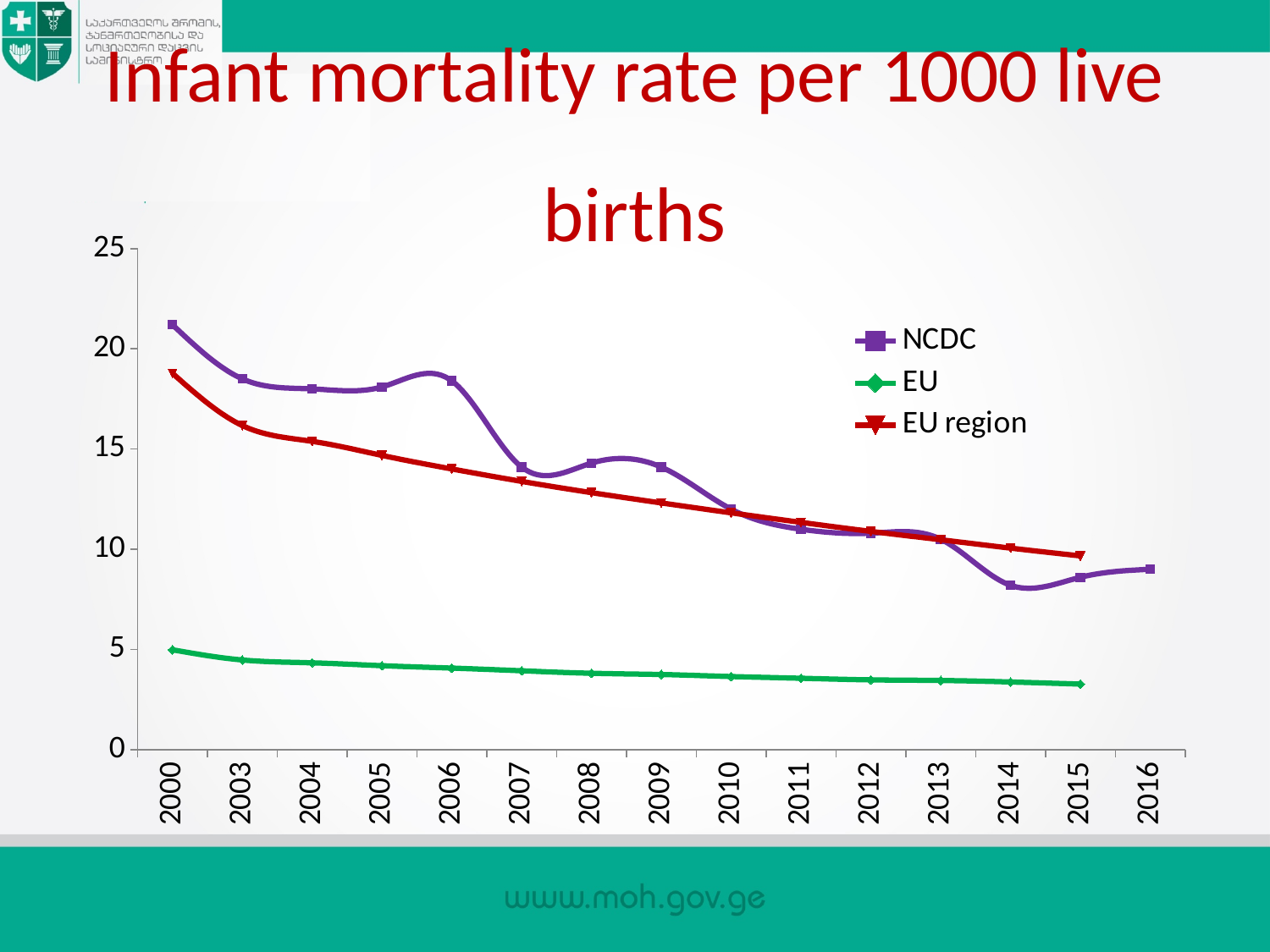
Does the EU region series rise or fall from 2000 to 2015? fall Does the EU series rise or fall from 2000 to 2015? fall Which series is drawn in green? EU What kind of chart is shown on the slide? line chart In which year is the NCDC series at its highest? 2000 How many years are shown on the x axis? 15 Is the EU region value for 2000 greater or less than 20? less Is the NCDC value for 2014 greater or less than 10? less In 2000, which series has the larger value, NCDC or EU? NCDC How many series does the legend list? 3 Is the NCDC value for 2000 greater or less than 20? greater What is the title of the chart? Infant mortality rate per 1000 live births